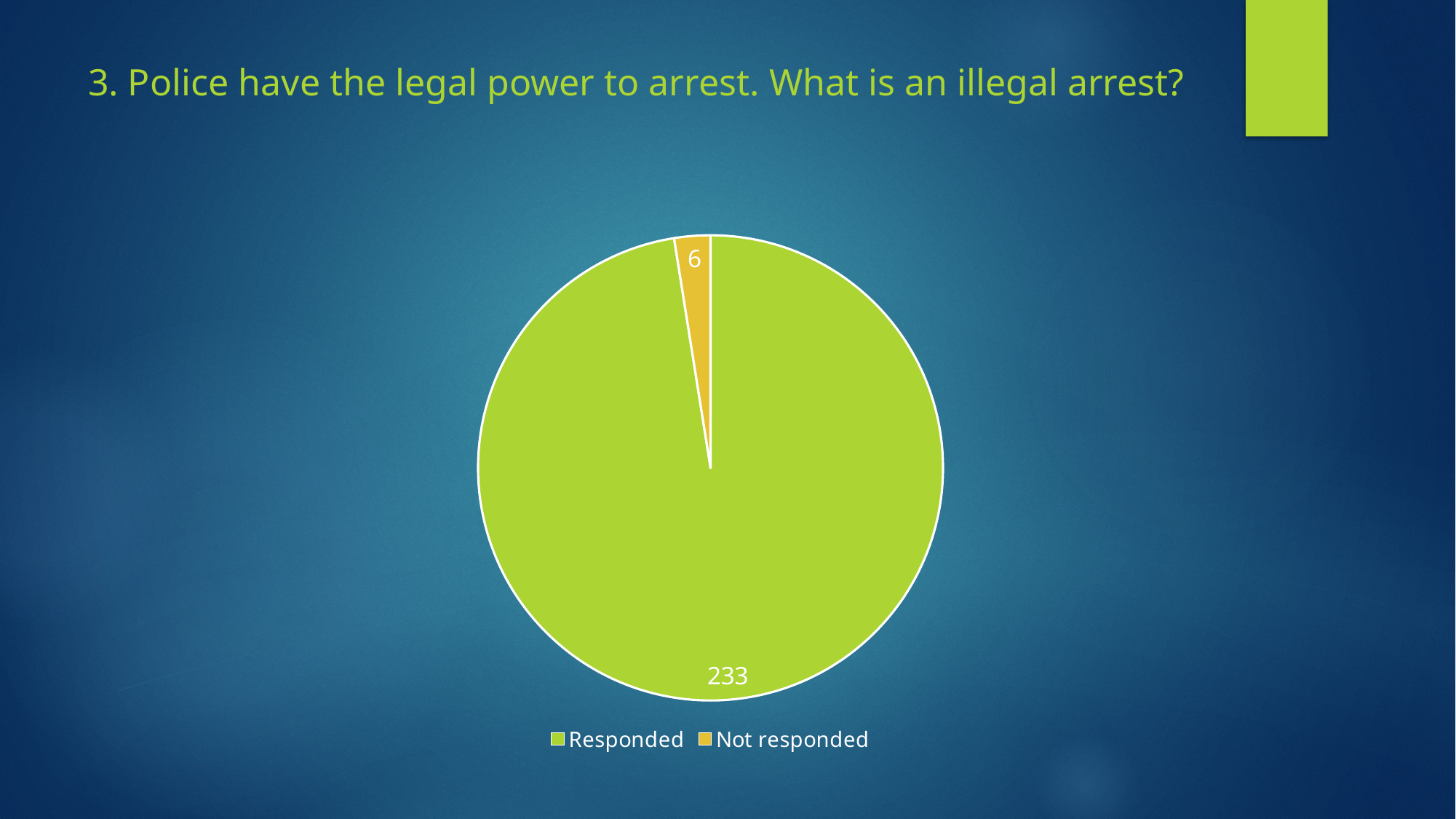
Which category has the smallest slice in the pie chart? Not responded Which category has the largest slice in the pie chart? Responded What colour is the Not responded slice? yellow/orange Which is larger, Responded or Not responded? Responded What type of chart is shown on the slide? pie chart How many slices does the pie chart have? 2 What is the total of all slices in the pie chart? 239 What is the value for Not responded in the pie chart? 6 What is the difference between the Responded and Not responded values? 227 How many people responded according to the pie chart? 233 How many entries does the legend list? 2 What is the title of the slide containing the pie chart? 3. Police have the legal power to arrest. What is an illegal arrest?